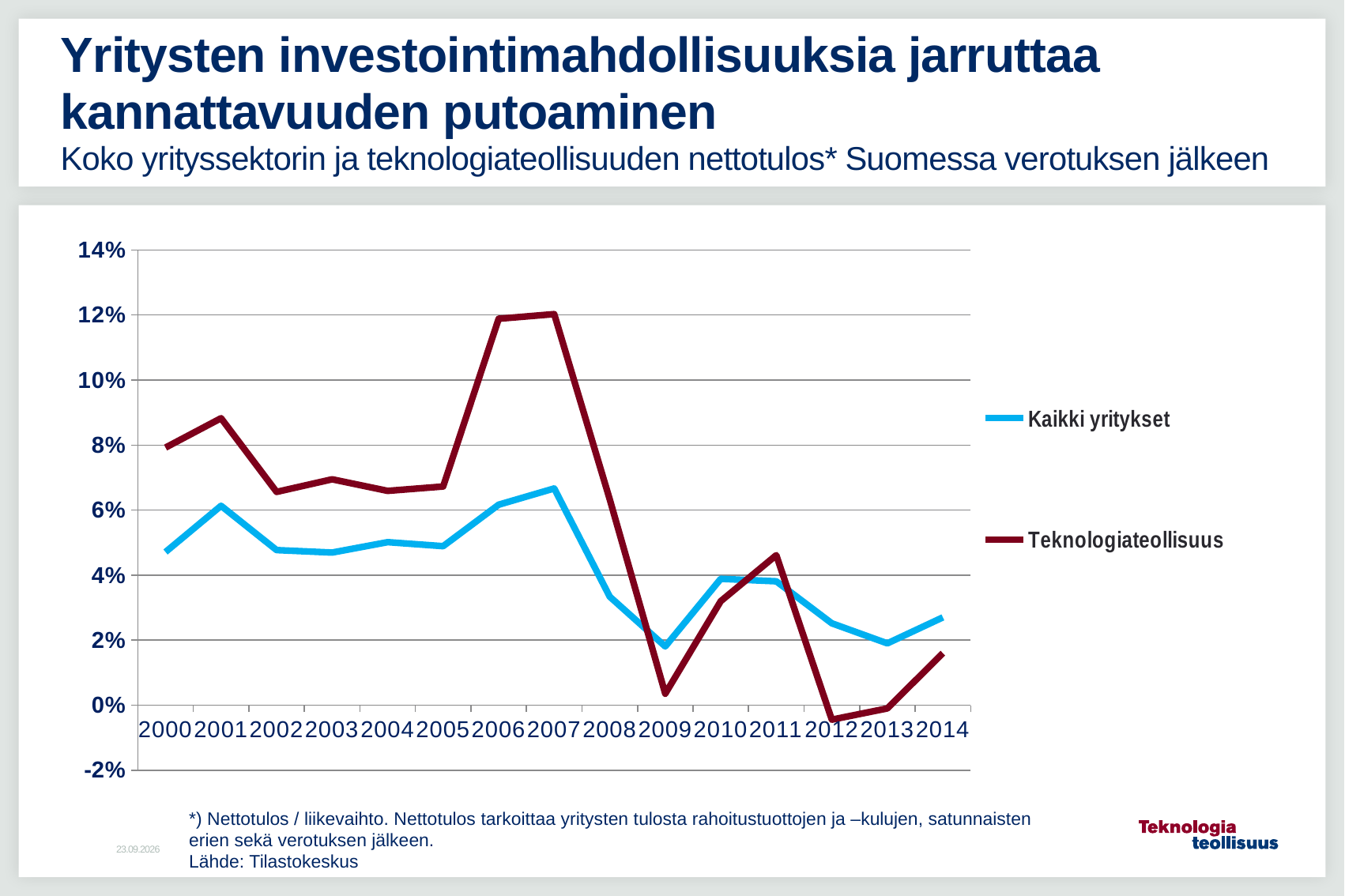
How many series does the legend list? 2 In 2000, which series has the higher value, Kaikki yritykset or Teknologiateollisuus? Teknologiateollisuus Is the value for Kaikki yritykset in 2001 greater or less than 8%? less In 2009, which series has the higher value, Kaikki yritykset or Teknologiateollisuus? Kaikki yritykset Which colour is used for the Teknologiateollisuus line? dark red Is the value for Teknologiateollisuus in 2006 greater or less than 10%? greater What kind of chart is shown on the slide? line chart In which year does the Kaikki yritykset series reach its highest value? 2007 Is the value for Teknologiateollisuus in 2012 greater or less than 0%? less Does the Kaikki yritykset series rise or fall from 2007 to 2009? fall How many years are plotted along the x axis? 15